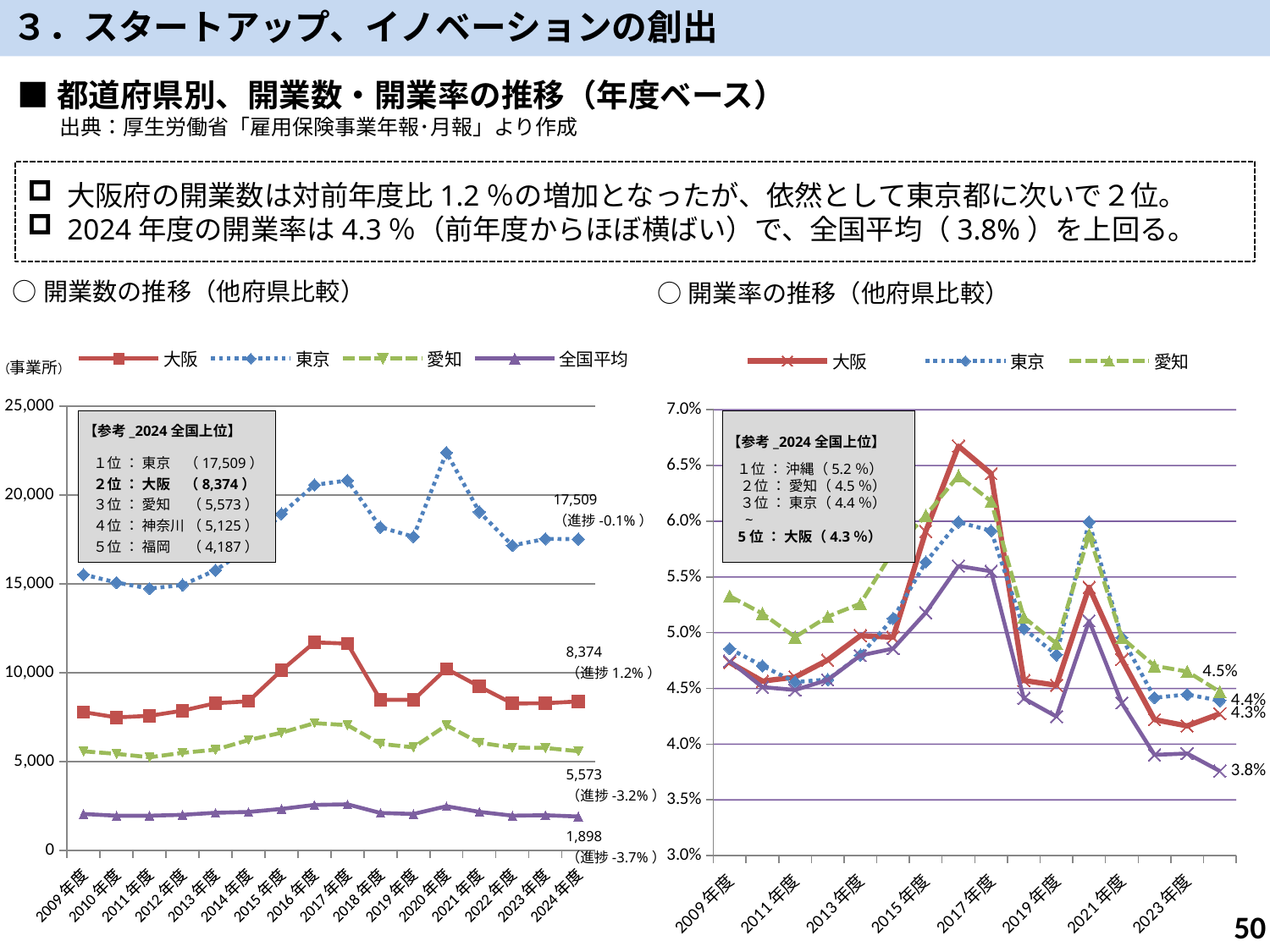
In the right chart (開業率の推移), which is larger in 2024年度, 愛知 or 東京? 愛知 In the left chart (開業数の推移), which series has the lowest value in 2024年度? 全国平均 In the right chart (開業率の推移), how many series does the legend list? 3 In the left chart (開業数の推移), how many fiscal years are plotted on the x axis? 16 In the left chart (開業数の推移), what is the difference between the 2024年度 values for 東京 and 大阪? 9,135 What kind of chart is the left chart titled 開業数の推移（他府県比較）? line chart In the right chart (開業率の推移), is the value for 大阪 in 2017年度 greater or less than 6.5%? less In the left chart (開業数の推移), what is the value for 東京 in 2024年度? 17,509 In the left chart (開業数の推移), what is the value for 大阪 in 2024年度? 8,374 In the right chart (開業率の推移), does the 大阪 line rise or fall from 2021年度 to 2023年度? fall In the left chart (開業数の推移), how many series does the legend list? 4 In the right chart (開業率の推移), what is the value for 大阪 in 2024年度? 4.3%